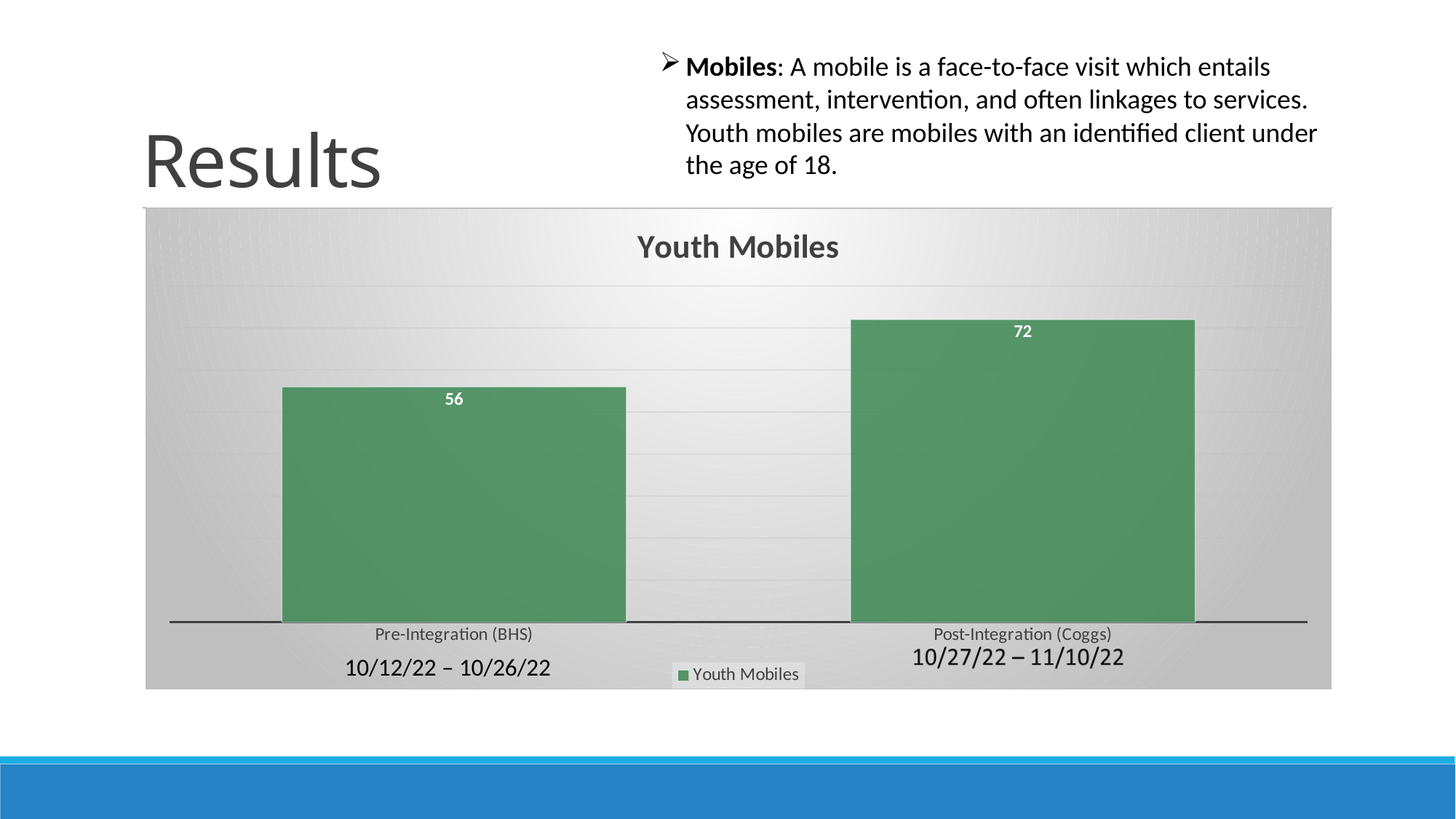
What is the difference between the Post-Integration (Coggs) and Pre-Integration (BHS) values in the Youth Mobiles chart? 16 What is the value for Post-Integration (Coggs) in the Youth Mobiles chart? 72 What kind of chart is the Youth Mobiles chart? Bar chart What is the value for Pre-Integration (BHS) in the Youth Mobiles chart? 56 How many categories are shown in the Youth Mobiles chart? 2 Which category has the lowest value in the Youth Mobiles chart? Pre-Integration (BHS) Do the values rise or fall from Pre-Integration (BHS) to Post-Integration (Coggs) in the Youth Mobiles chart? Rise How many series does the legend of the Youth Mobiles chart list? 1 Which is larger in the Youth Mobiles chart: Pre-Integration (BHS) or Post-Integration (Coggs)? Post-Integration (Coggs) What is the title of the chart on the slide? Youth Mobiles Which category has the highest value in the Youth Mobiles chart? Post-Integration (Coggs) What date range is shown under the Post-Integration (Coggs) bar in the Youth Mobiles chart? 10/27/22 – 11/10/22